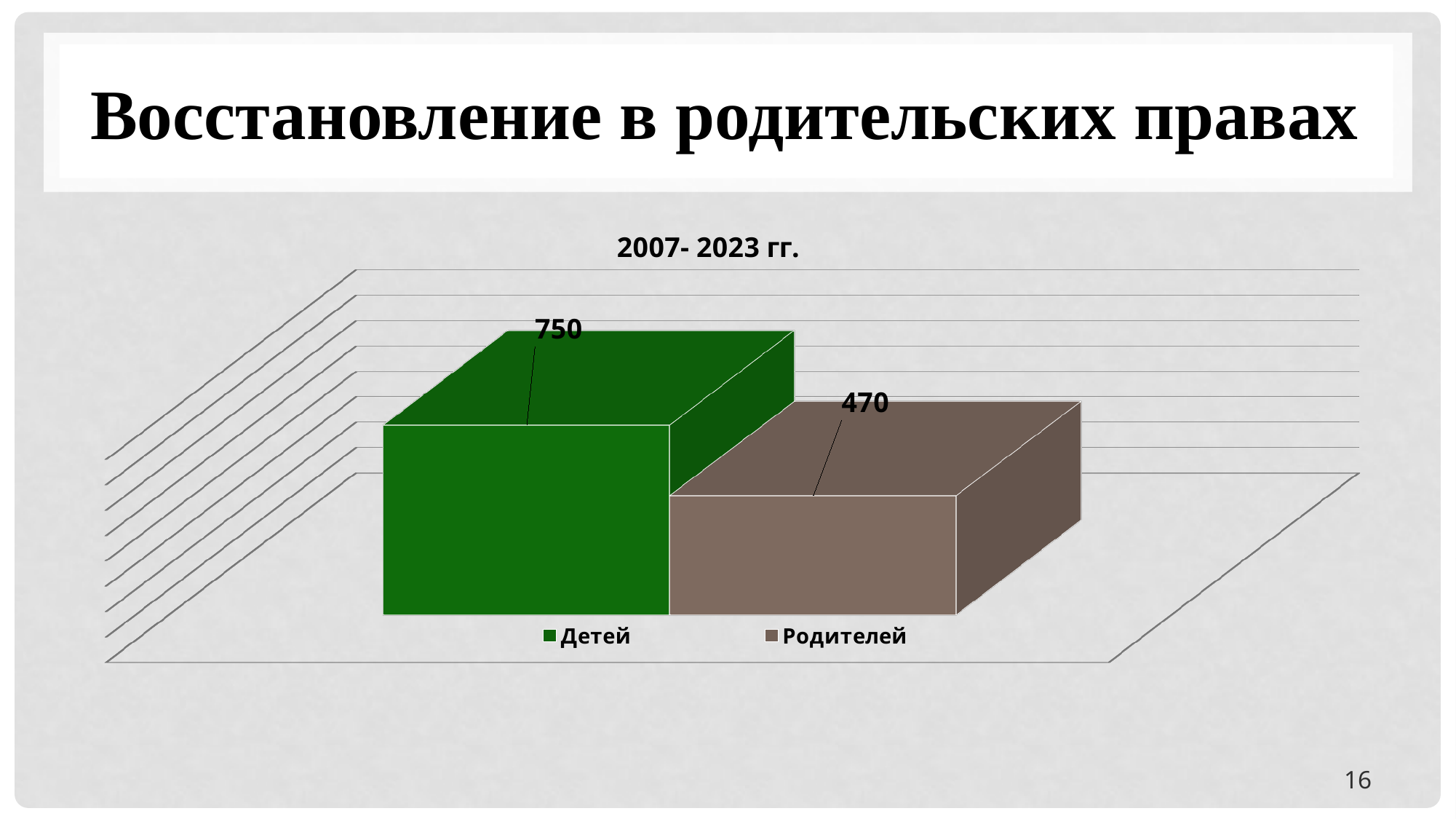
Which series has the highest value? Детей What colour is the bar for Детей? Green How many bars are plotted on the chart? 2 What is the title of the chart? 2007- 2023 гг. What is the difference between the values for Детей and Родителей? 280 Which series has the lowest value? Родителей What kind of chart is shown on the slide? Bar chart What is the total of the two plotted values? 1220 How many series does the legend list? 2 What is the value for Родителей? 470 Which is larger, the value for Детей or the value for Родителей? Детей What is the value for Детей? 750